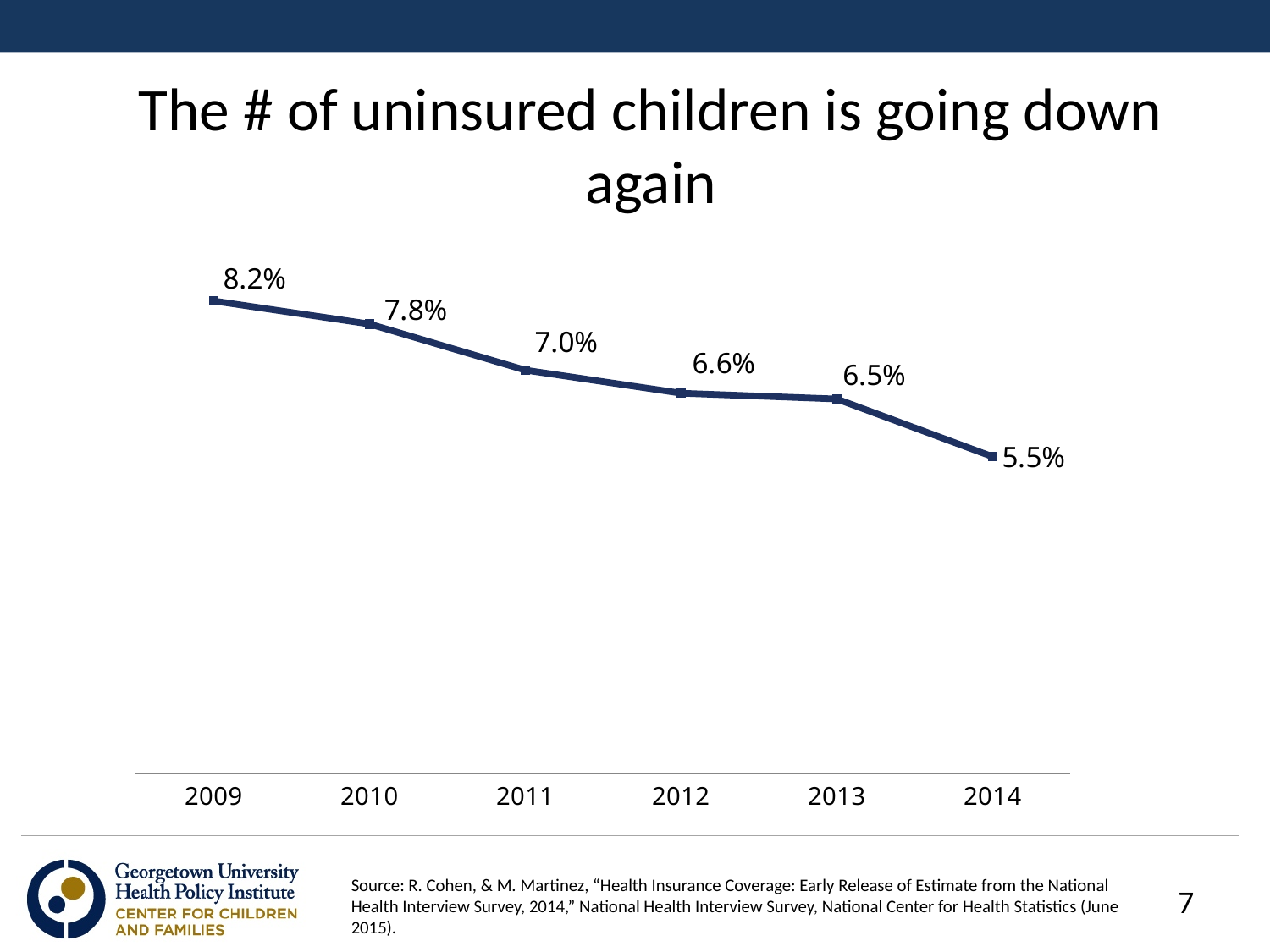
Do the values rise or fall from 2009 to 2014? fall Which year has the highest value? 2009 What is the value for 2012? 6.6% What is the value for 2009? 8.2% What is the difference between the values for 2013 and 2014? 1.0% What is the value for 2014? 5.5% Which is larger, the value for 2010 or the value for 2011? 2010 What kind of chart is shown on the slide? line chart How many years are plotted on the chart? 6 What is the title of the slide? The # of uninsured children is going down again What is the difference between the values for 2009 and 2014? 2.7% Which year has the lowest value? 2014